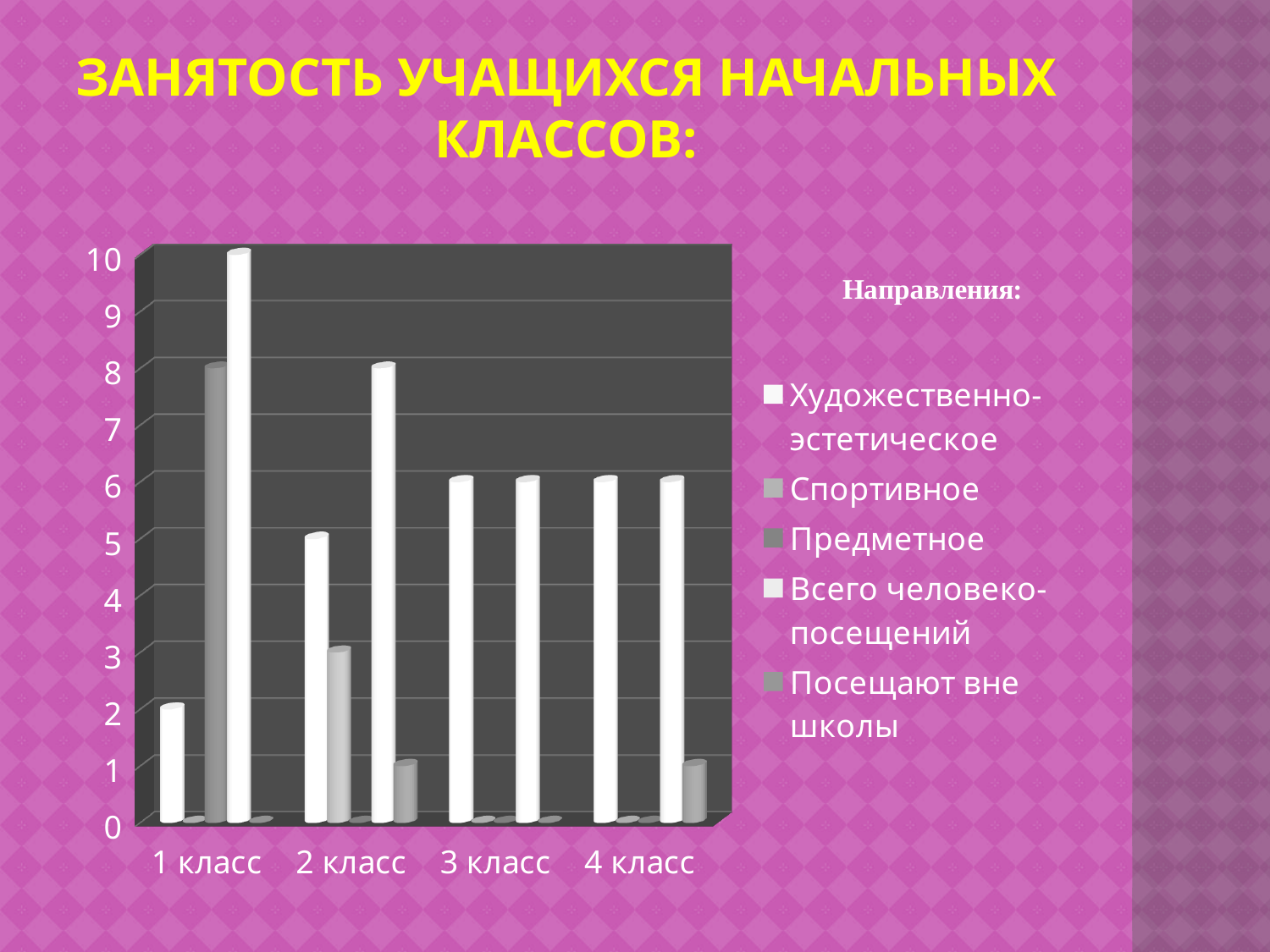
What is the value of Художественно-эстетическое for 1 класс? 2 How many series does the chart legend list? 5 What is the title of the chart's legend? Направления: What is the value of Всего человеко-посещений for 2 класс? 8 What kind of chart is shown on the slide? bar chart Which class has the highest value of Всего человеко-посещений? 1 класс What is the value of Всего человеко-посещений for 1 класс? 10 How many classes (categories) are shown on the x axis of the chart? 4 What is the difference between Всего человеко-посещений for 1 класс and for 2 класс? 2 What is the value of Спортивное for 2 класс? 3 Which is larger: Художественно-эстетическое for 2 класс or Художественно-эстетическое for 1 класс? 2 класс What is the value of Художественно-эстетическое for 2 класс? 5